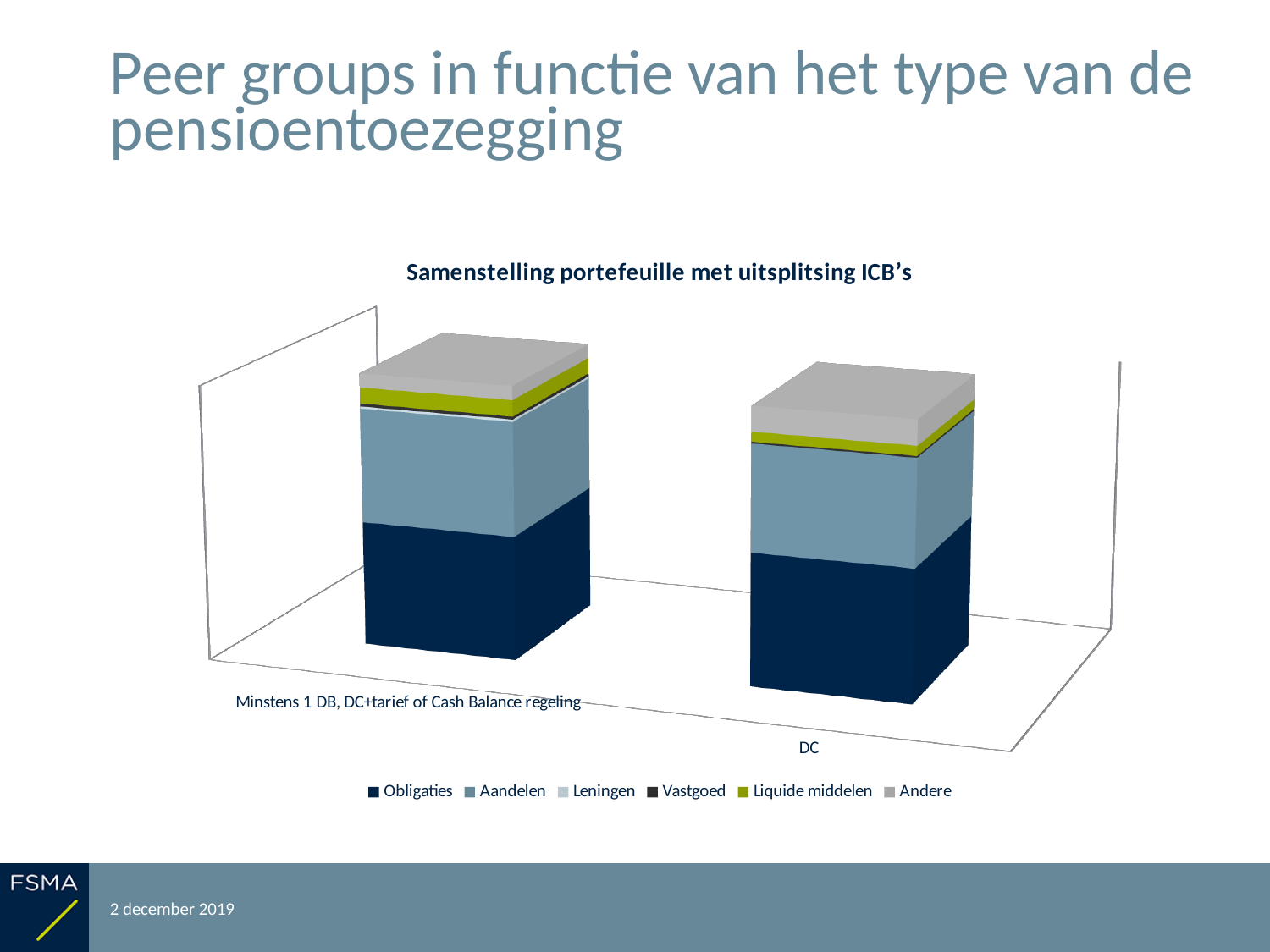
Which series is listed first in the chart legend? Obligaties Which series forms the largest segment of the bar for 'Minstens 1 DB, DC+tarief of Cash Balance regeling'? Obligaties Which series forms the largest segment of the DC bar? Obligaties What is the label of the second category on the x axis? DC What kind of chart is shown on the slide? Stacked bar chart What is the title of the chart? Samenstelling portefeuille met uitsplitsing ICB’s Within the DC bar, which segment is larger: Aandelen or Liquide middelen? Aandelen Within the DC bar, which segment is larger: Obligaties or Aandelen? Obligaties How many series does the chart legend list? 6 How many categories (bars) are shown on the x axis of the chart? 2